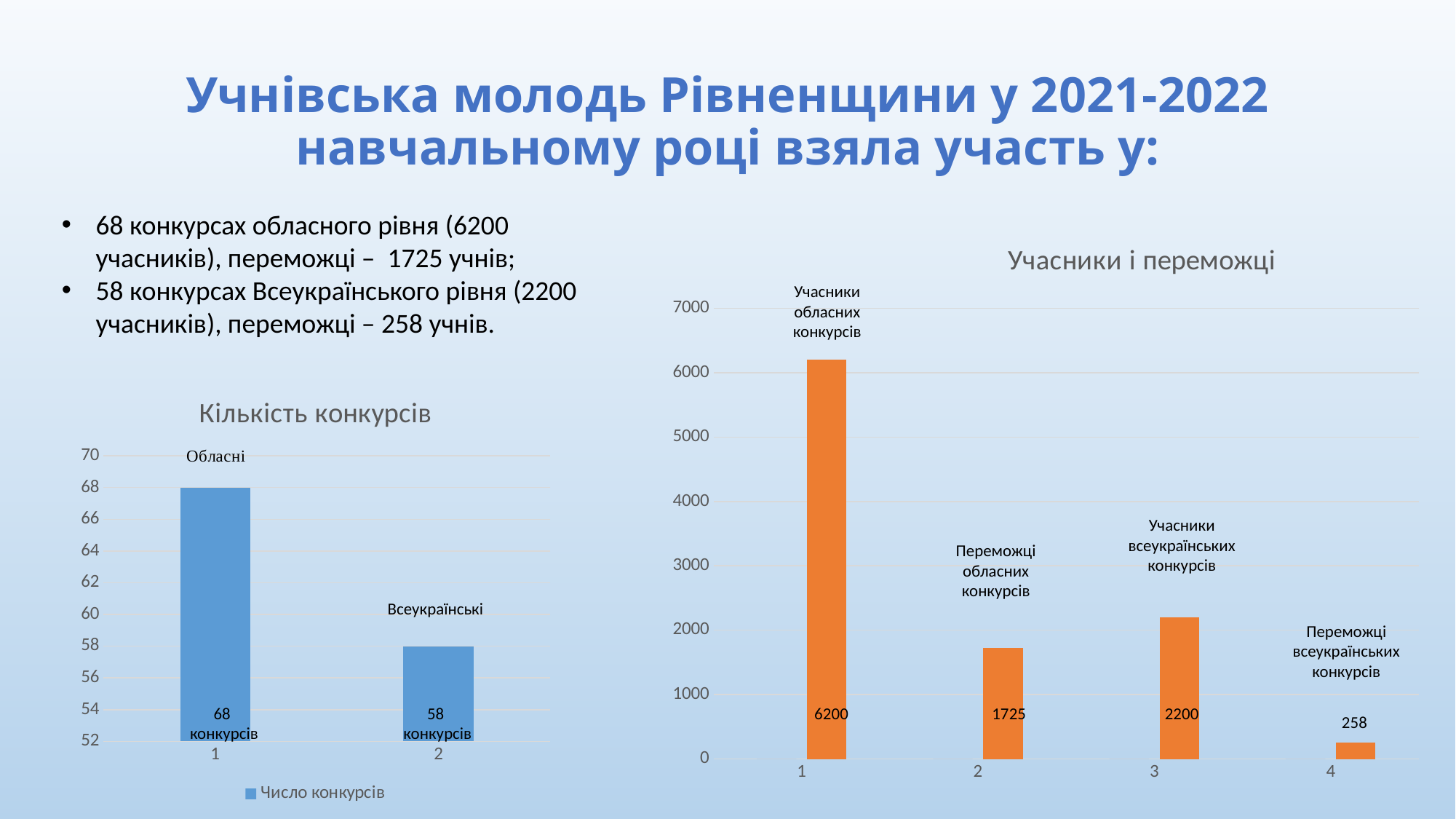
What type of chart is the chart titled "Учасники і переможці"? Bar chart In the chart titled "Учасники і переможці", how many bars are plotted? 4 In the chart titled "Учасники і переможці", what is the difference between Учасники всеукраїнських конкурсів and Переможці обласних конкурсів? 475 In the chart titled "Кількість конкурсів", what is the value for Всеукраїнські? 58 In the chart titled "Кількість конкурсів", what is the value for Обласні? 68 In the chart titled "Кількість конкурсів", what series name does the legend show? Число конкурсів In the chart titled "Учасники і переможці", which category has the lowest value? Переможці всеукраїнських конкурсів In the chart titled "Учасники і переможці", which category has the highest value? Учасники обласних конкурсів In the chart titled "Учасники і переможці", what is the value for Учасники обласних конкурсів? 6200 In the chart titled "Учасники і переможці", which is larger: Переможці обласних конкурсів or Учасники всеукраїнських конкурсів? Учасники всеукраїнських конкурсів In the chart titled "Кількість конкурсів", what is the difference between the Обласні and Всеукраїнські values? 10 In the chart titled "Учасники і переможці", what is the value for Переможці всеукраїнських конкурсів? 258